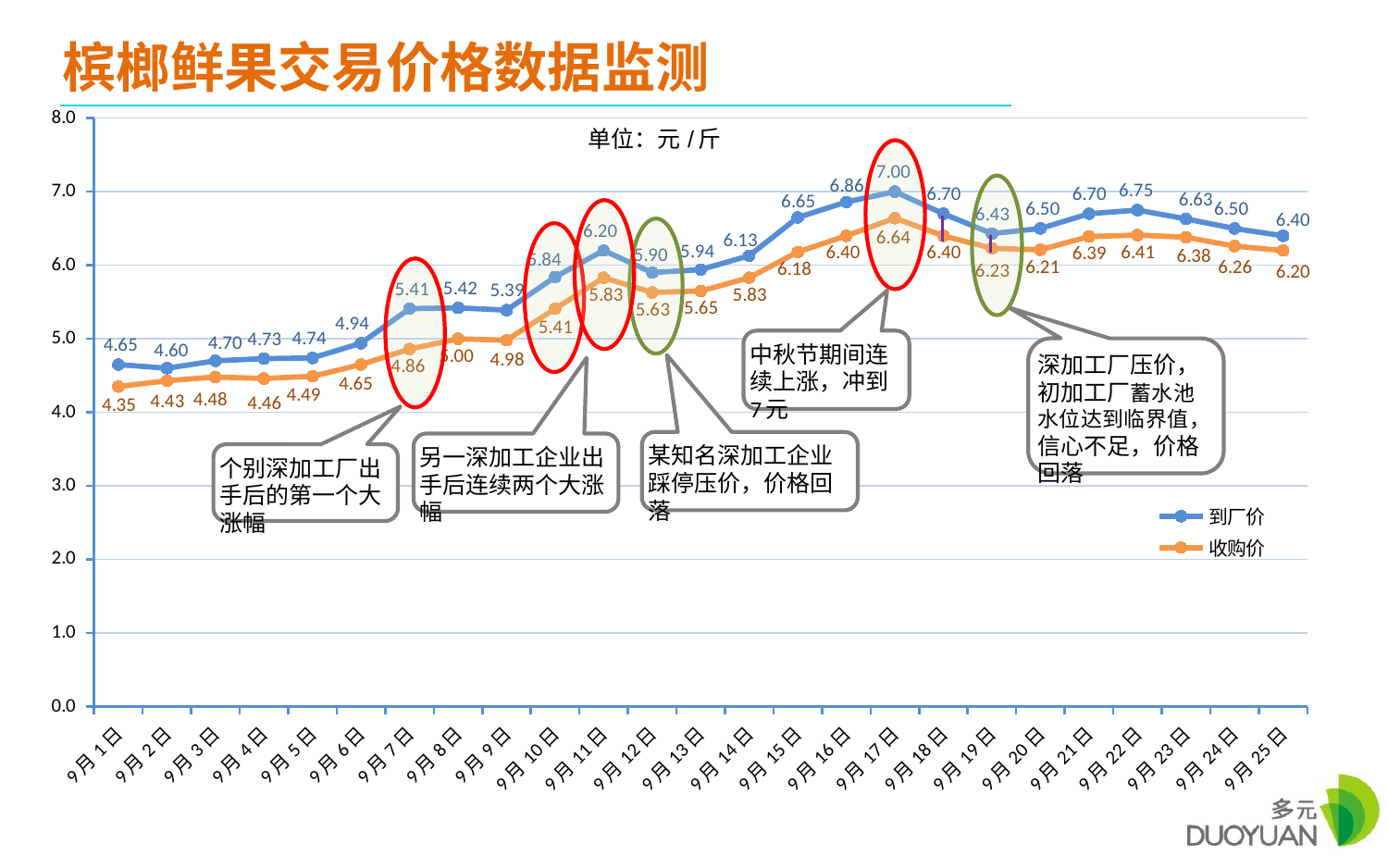
What is the 收购价 value on 9月1日? 4.35 What is the difference between the 到厂价 and the 收购价 on 9月17日? 0.36 What unit is stated for the values in the chart? 元/斤 What is the 到厂价 value on 9月11日? 6.20 What is the 到厂价 value on 9月17日? 7.00 How many series does the legend list? 2 What type of chart is shown on the slide? line chart What is the difference between the 收购价 on 9月25日 and on 9月1日? 1.85 On which date is the 收购价 lowest? 9月1日 How many dates are shown on the x axis? 25 On which date is the 到厂价 highest? 9月17日 Which is larger on 9月7日, the 到厂价 or the 收购价? 到厂价